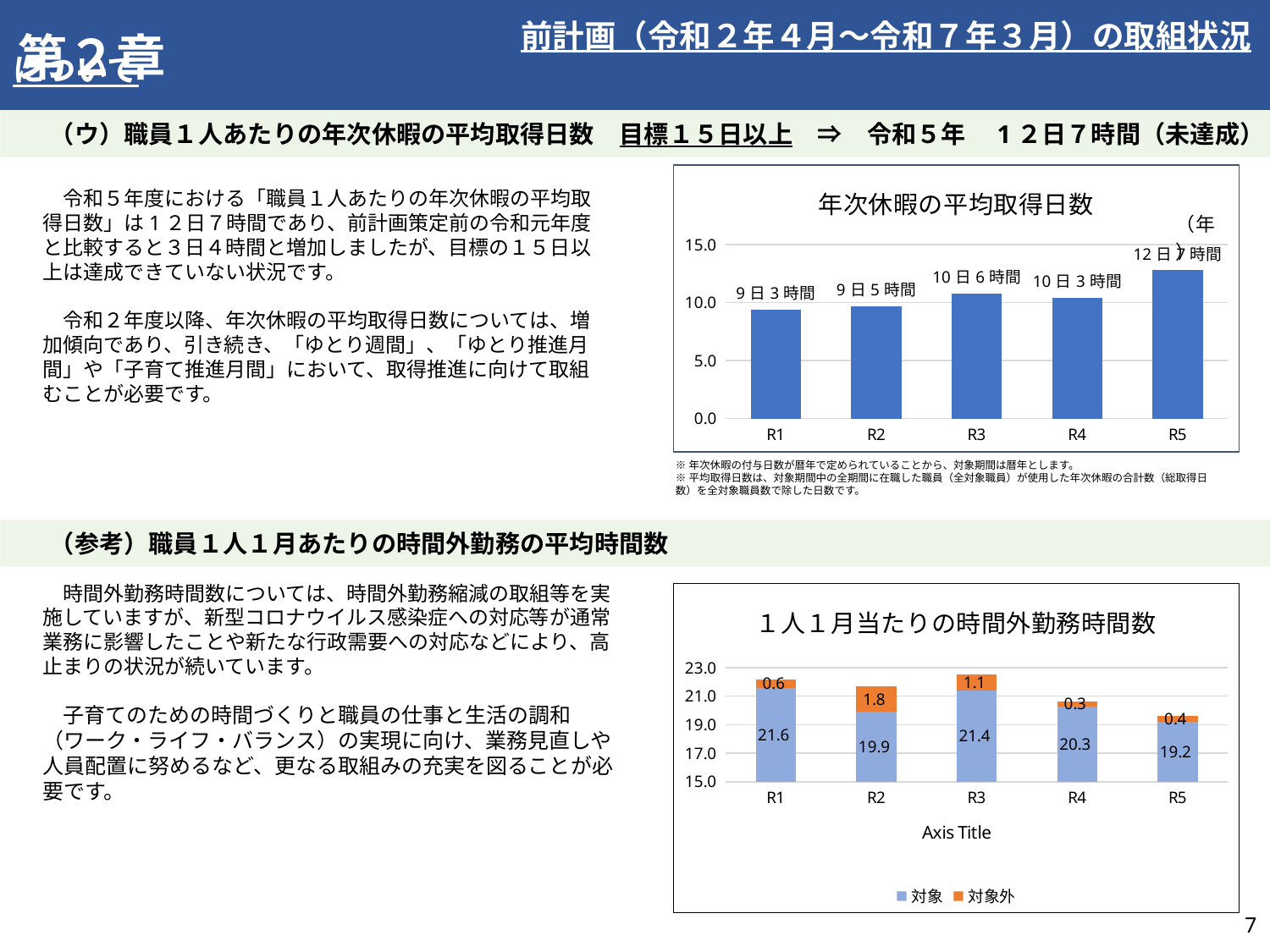
In the chart titled 1人1月当たりの時間外勤務時間数, what is the 対象外 value for R3? 1.1 In the chart titled 1人1月当たりの時間外勤務時間数, what is the total of the stacked bar for R1? 22.2 In the chart titled 1人1月当たりの時間外勤務時間数, how many series does the legend list? 2 In the chart titled 1人1月当たりの時間外勤務時間数, what is the difference between the 対象 values for R1 and R5? 2.4 In the chart titled 年次休暇の平均取得日数, which category has the highest value? R5 In the chart titled 年次休暇の平均取得日数, how many categories are shown on the x axis? 5 In the chart titled 年次休暇の平均取得日数, which category has the lowest value? R1 What kind of chart is the chart titled 年次休暇の平均取得日数? bar chart In the chart titled 1人1月当たりの時間外勤務時間数, what is the 対象 value for R2? 19.9 In the chart titled 年次休暇の平均取得日数, is the value for R5 greater or less than 10.0? greater In the chart titled 年次休暇の平均取得日数, what is the value for R1? 9日3時間 In the chart titled 年次休暇の平均取得日数, what is the value for R3? 10日6時間